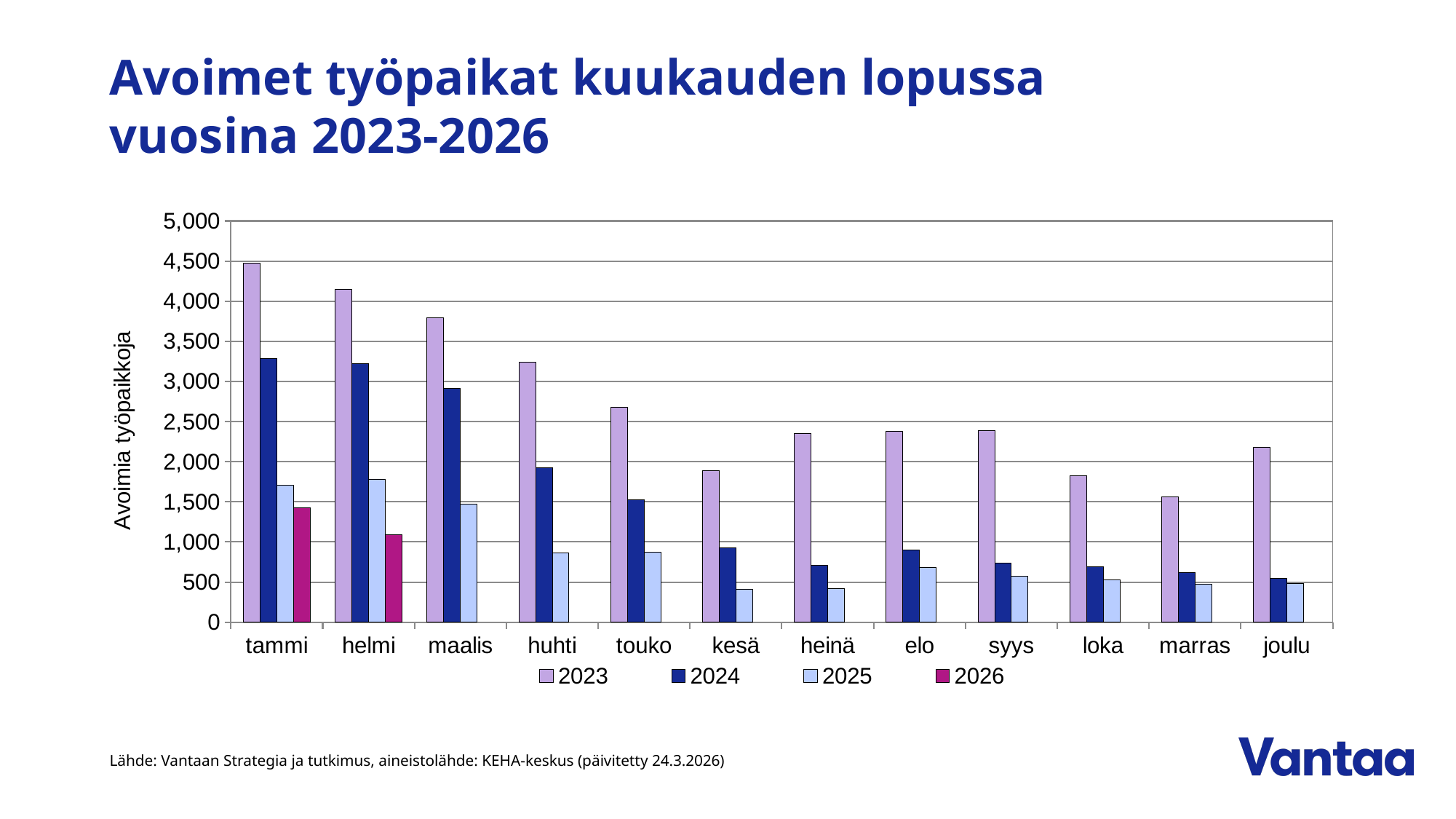
What kind of chart is shown on the slide? bar chart Which month has the highest value for the 2023 series? tammi Is the 2026 value for tammi greater or less than 1,500? less How many months are shown on the x axis? 12 What is the label on the vertical axis? Avoimia työpaikkoja Which month has the lowest value for the 2023 series? marras How many series does the legend list? 4 Does the 2024 series generally rise or fall from tammi to joulu? fall Which month has the lowest value for the 2024 series? joulu Is the 2024 value for huhti greater or less than 2,000? less For helmi, which is larger: the 2025 value or the 2026 value? 2025 Is the 2023 value for tammi greater or less than 4,000? greater